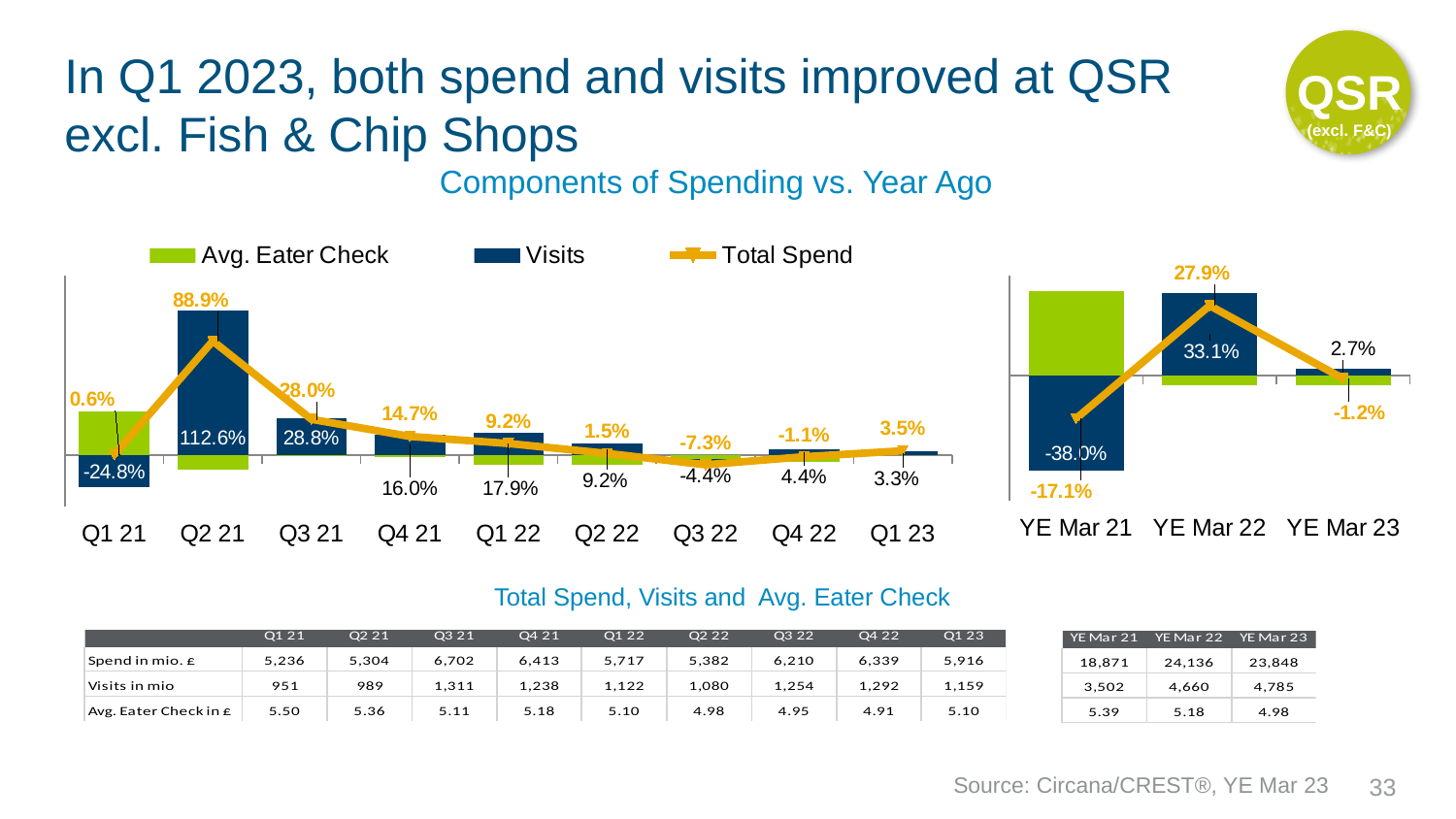
On the left quarterly chart, what is the Total Spend value for Q1 23? 3.5% On the left quarterly chart, which quarter has the highest Total Spend value? Q2 21 On the left quarterly chart, what is the Visits value for Q1 22? 17.9% How many quarters are shown on the left quarterly chart? 9 How many series does the legend list for the charts? 3 On the left quarterly chart, is the Total Spend value higher in Q4 21 or Q1 22? Q4 21 On the left quarterly chart, what is the Total Spend value for Q2 21? 88.9% On the right yearly chart, what is the Total Spend value for YE Mar 22? 27.9% On the left quarterly chart, which quarter has the lowest Total Spend value? Q3 22 On the right yearly chart, what is the Visits value for YE Mar 21? -38.0% What kind of chart is the left quarterly chart? bar chart with a line On the right yearly chart, what is the difference between the Visits values for YE Mar 22 and YE Mar 23? 30.4 percentage points